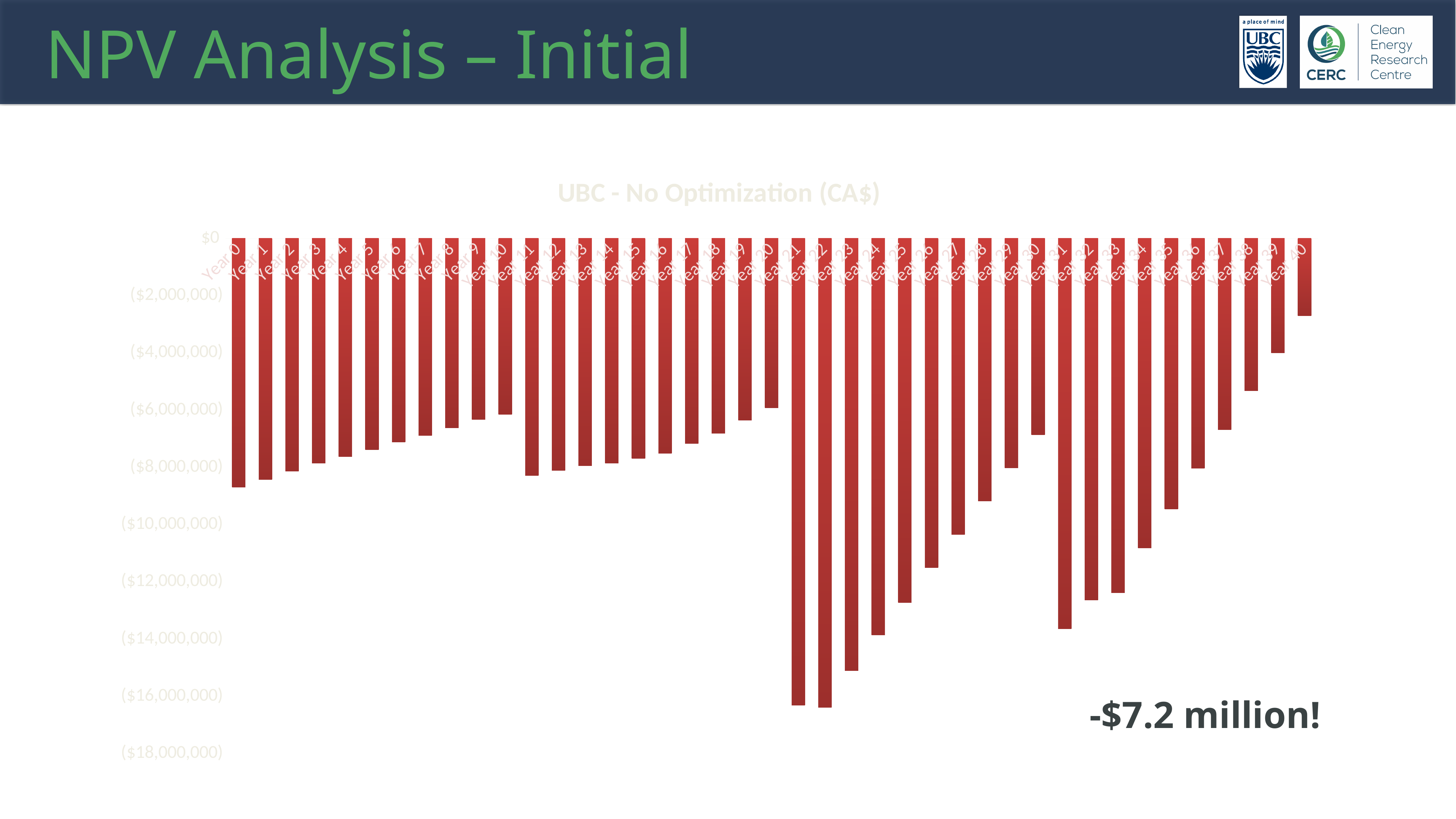
Do the values rise or fall from Year 0 to Year 10? rise What figure is written in large text at the bottom right of the slide? -$7.2 million! How many year categories are plotted on the x axis? 41 Which is lower, the value for Year 21 or the value for Year 10? Year 21 Is the value for Year 31 greater or less than ($12,000,000)? less Is the value for Year 0 greater or less than ($8,000,000)? less Is the value for Year 10 greater or less than ($8,000,000)? greater What is the title of the chart? UBC - No Optimization (CA$) Which year has the highest (least negative) value? Year 40 What kind of chart is shown on the slide? Bar chart